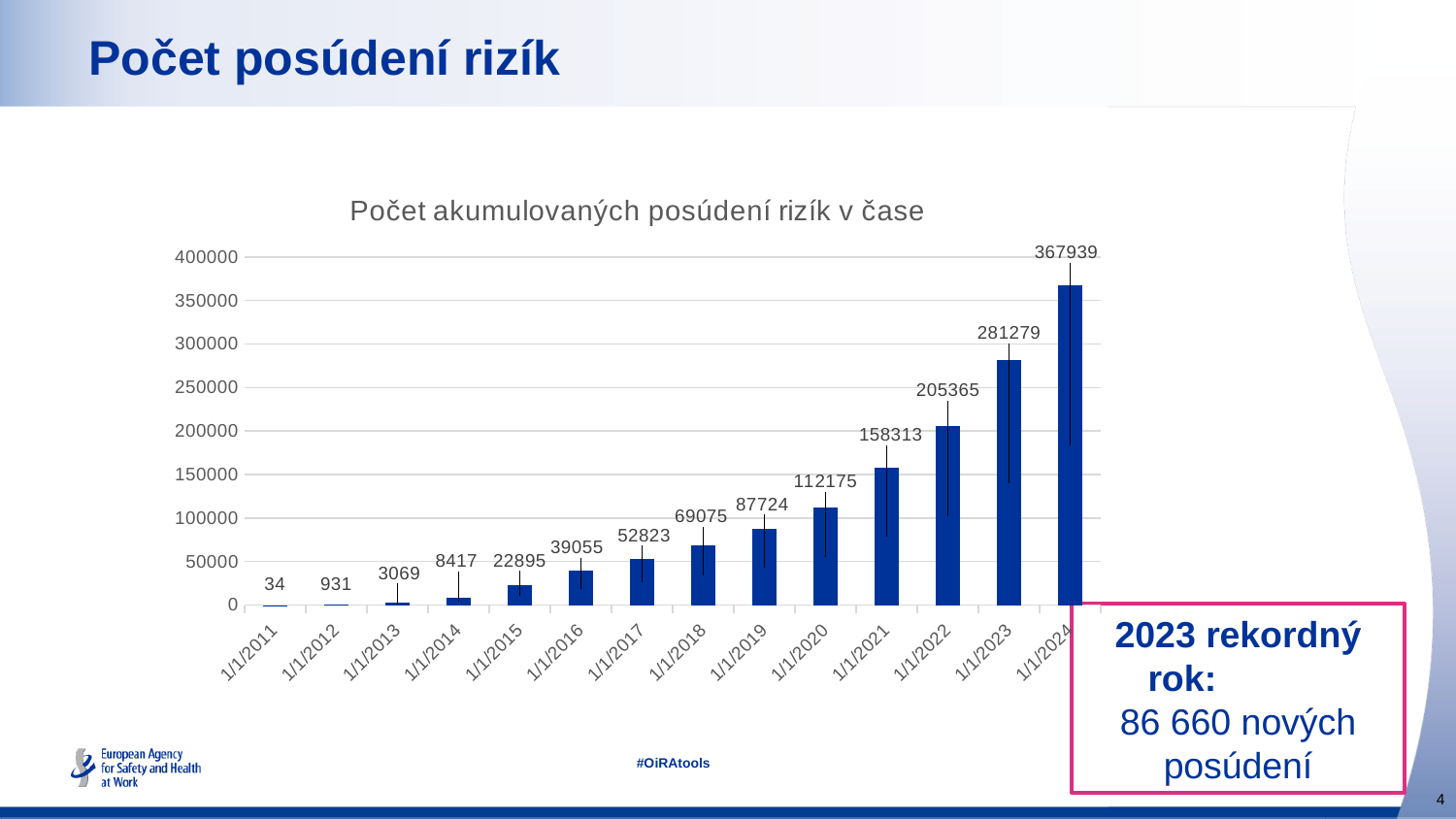
What kind of chart is shown on the slide? bar chart What is the difference between the values for 1/1/2024 and 1/1/2023? 86660 How many categories are shown on the x axis? 14 What is the value for 1/1/2024? 367939 What is the difference between the values for 1/1/2021 and 1/1/2020? 46138 Is the value for 1/1/2022 greater or less than 200000? greater Which category has the highest value? 1/1/2024 What is the value for 1/1/2017? 52823 Do the values rise or fall from 1/1/2011 to 1/1/2024? rise Which is larger, the value for 1/1/2019 or the value for 1/1/2018? 1/1/2019 Which category has the lowest value? 1/1/2011 What is the value for 1/1/2011? 34